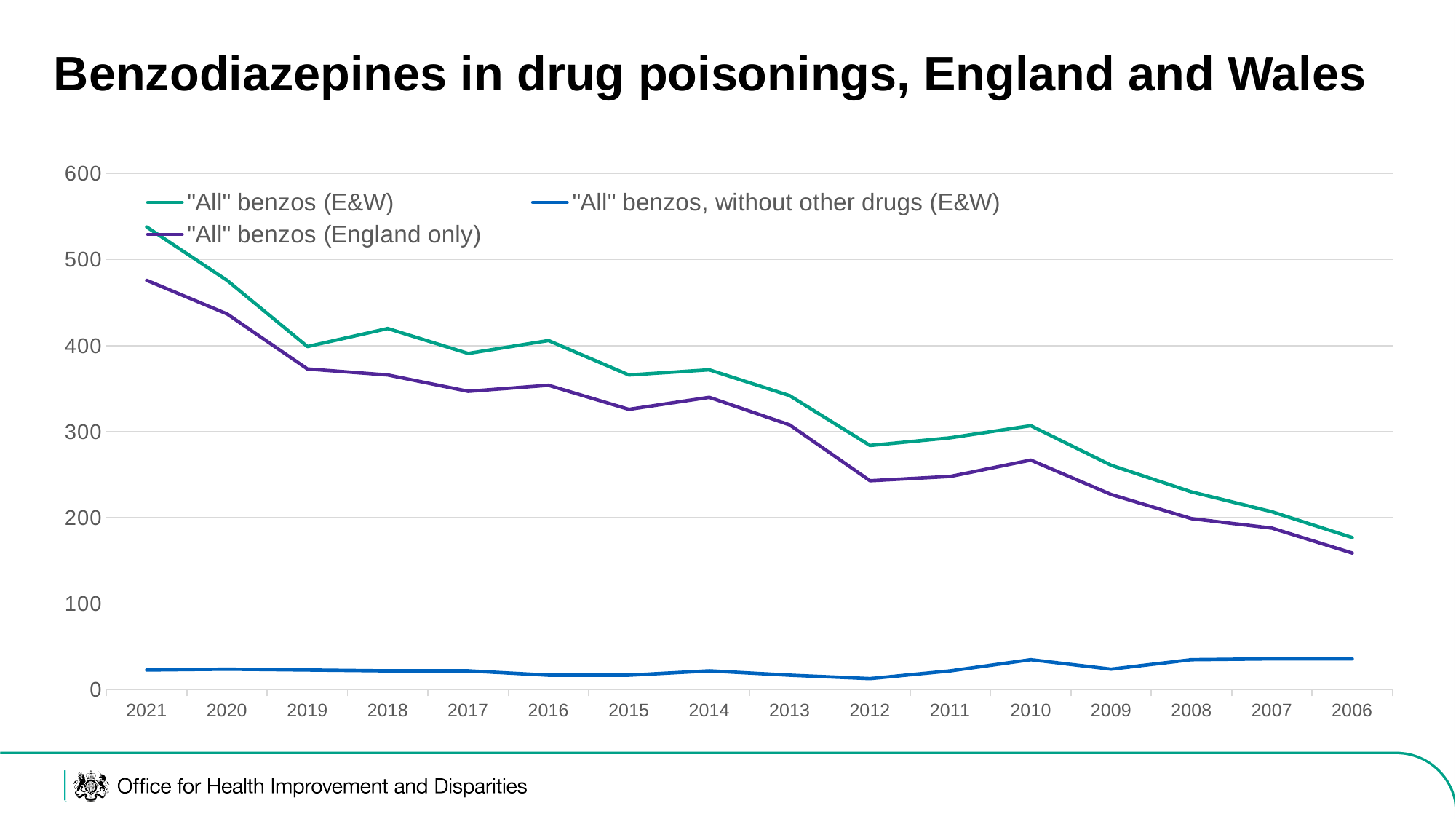
How many years are shown on the x axis? 16 Is the value for "All" benzos (England only) in 2012 greater or less than 300? less Is the value for "All" benzos, without other drugs (E&W) in 2010 greater or less than 100? less In which year is the value for "All" benzos (E&W) highest? 2021 How many series does the legend list? 3 What kind of chart is shown on the slide? line chart Which is larger in 2021: "All" benzos (E&W) or "All" benzos (England only)? "All" benzos (E&W) Moving from 2021 on the left to 2006 on the right, do the values for "All" benzos (E&W) generally rise or fall? fall In which year is the value for "All" benzos (England only) lowest? 2006 What is the title of the chart? Benzodiazepines in drug poisonings, England and Wales Is the value for "All" benzos (E&W) in 2006 greater or less than 200? less